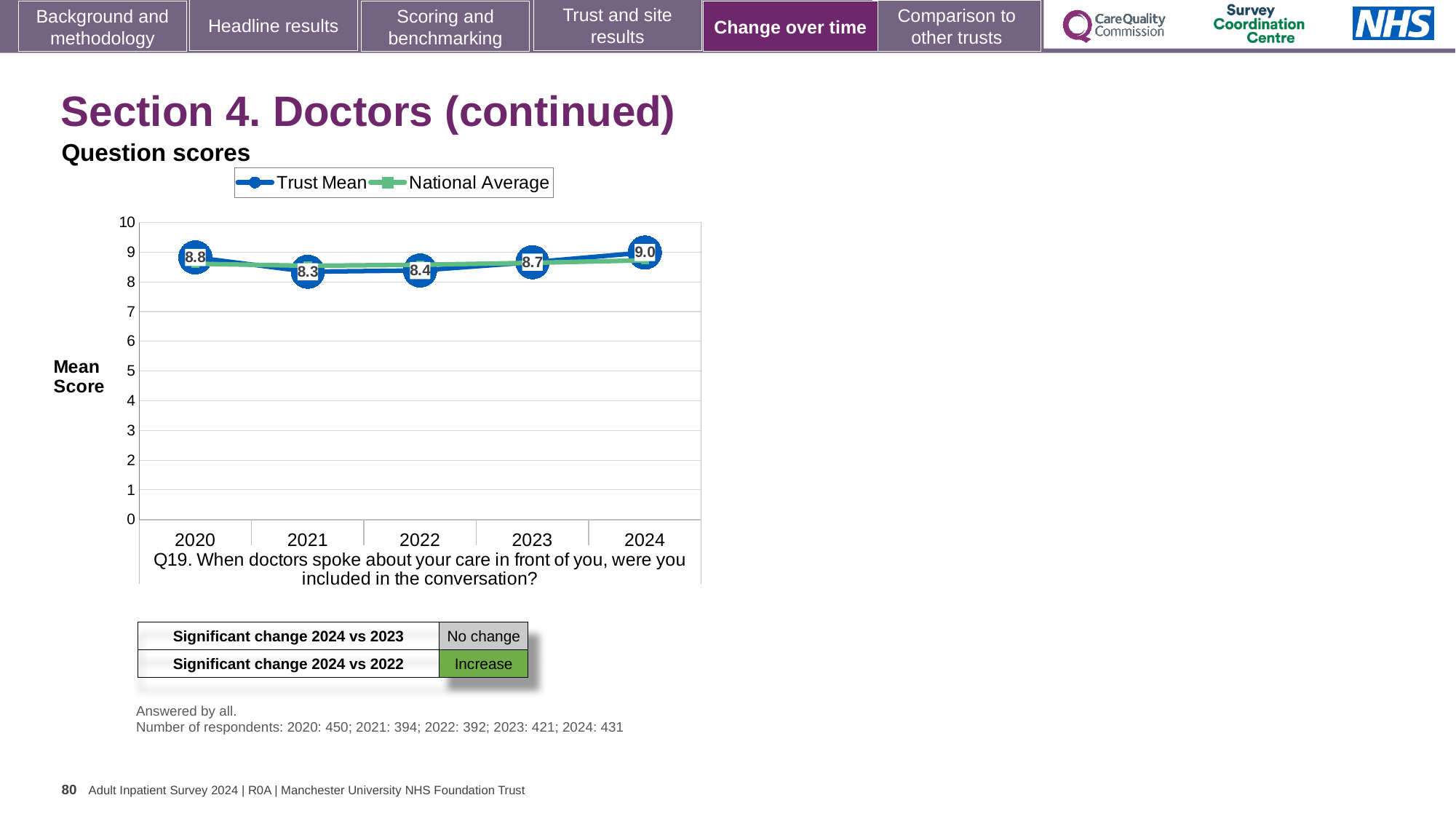
Does the Trust Mean score rise or fall from 2021 to 2024? Rise What is the Trust Mean score for 2024? 9.0 Is the National Average value for 2024 greater or less than 8? greater Which year has the larger Trust Mean score, 2020 or 2023? 2020 What is the Trust Mean score for 2020? 8.8 What is the Trust Mean score for 2021? 8.3 What is the difference between the Trust Mean scores for 2024 and 2021? 0.7 In which year is the Trust Mean score lowest? 2021 What kind of chart is shown on the slide? Line chart In which year is the Trust Mean score highest? 2024 How many years are plotted on the x axis? 5 How many series does the legend list? 2